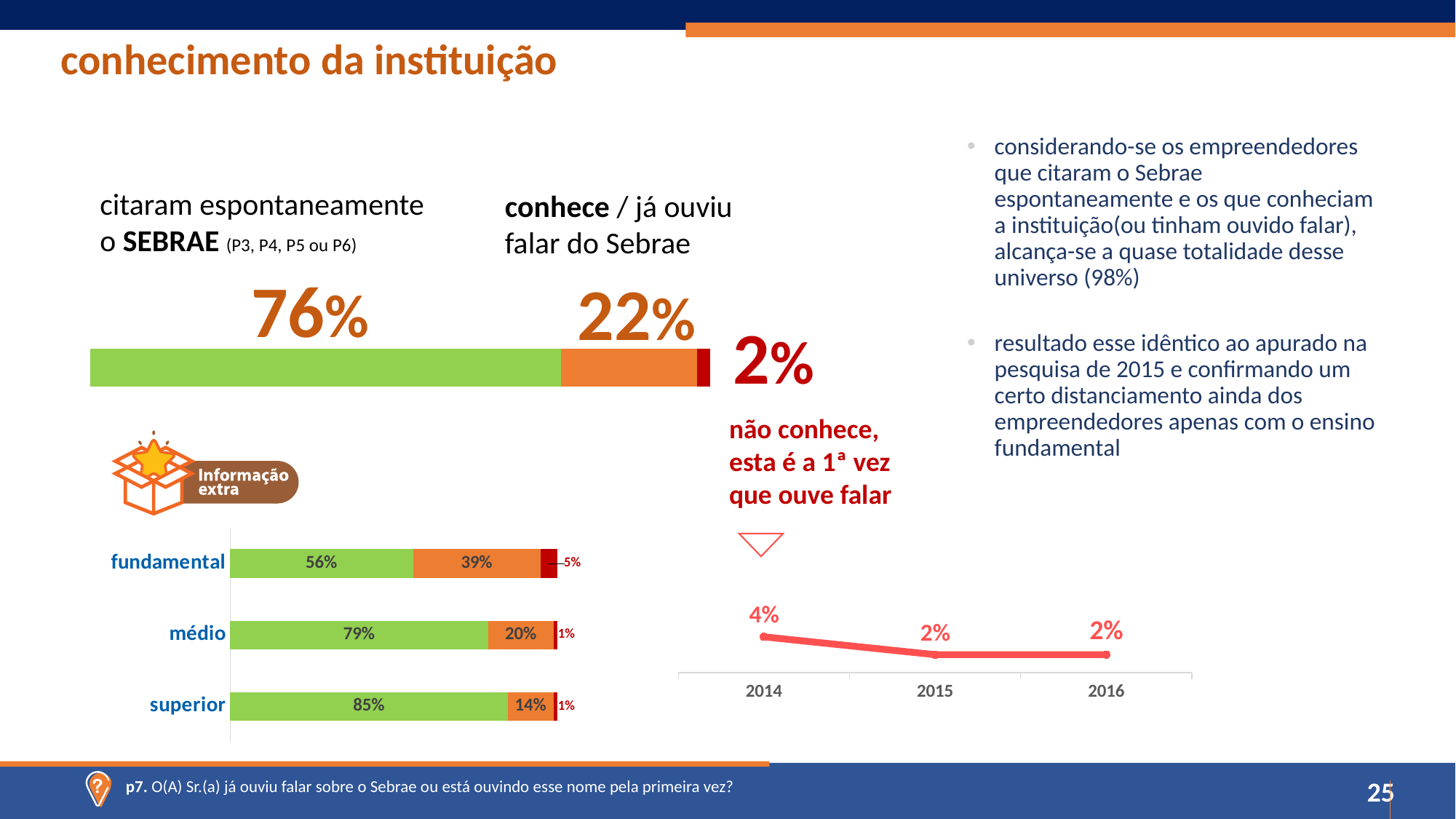
In the line chart at the bottom right, do the values rise or fall from 2014 to 2015? fall In the stacked bar chart by education level at the bottom left, what is the red segment value for 'fundamental'? 5% In the line chart at the bottom right, what is the value for 2014? 4% In the stacked bar chart by education level at the bottom left, what is the green segment value for 'superior'? 85% In the stacked bar chart by education level at the bottom left, what is the difference between the green segment values for 'superior' and 'fundamental'? 29% In the stacked bar chart by education level at the bottom left, how many categories are shown? 3 In the stacked bar chart by education level at the bottom left, which category has the lowest green segment value? fundamental In the stacked bar chart by education level at the bottom left, is the orange segment for 'médio' larger or smaller than the orange segment for 'superior'? larger In the stacked bar chart by education level at the bottom left, which category has the highest green segment value? superior In the line chart at the bottom right, what is the value for 2016? 2% In the wide stacked bar at the top of the slide, what percentage is shown for the green segment ('citaram espontaneamente o SEBRAE')? 76% In the stacked bar chart by education level at the bottom left, what is the orange segment value for 'fundamental'? 39%